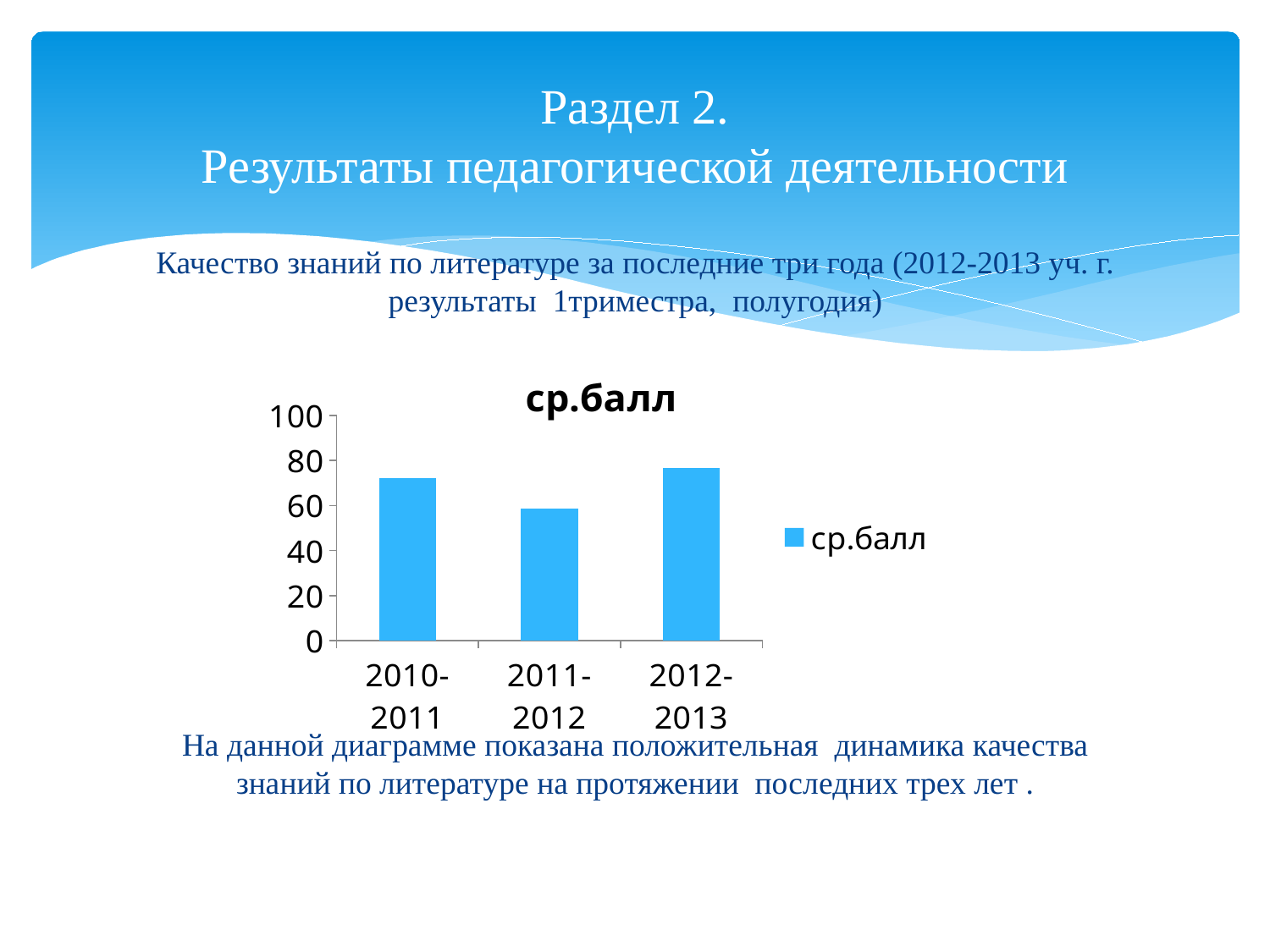
How many series does the chart legend list? 1 Is the value for 2010-2011 greater or less than 60? greater Does the value rise or fall from 2011-2012 to 2012-2013? rise What is the title of the chart? ср.балл Which school year has the highest value in the chart? 2012-2013 What is the legend entry of the chart? ср.балл How many categories (school years) are shown on the x axis of the chart? 3 Which is larger, the value for 2010-2011 or the value for 2011-2012? 2010-2011 Is the value for 2011-2012 greater or less than 40? greater Which school year has the lowest value in the chart? 2011-2012 What kind of chart is shown on the slide? bar chart